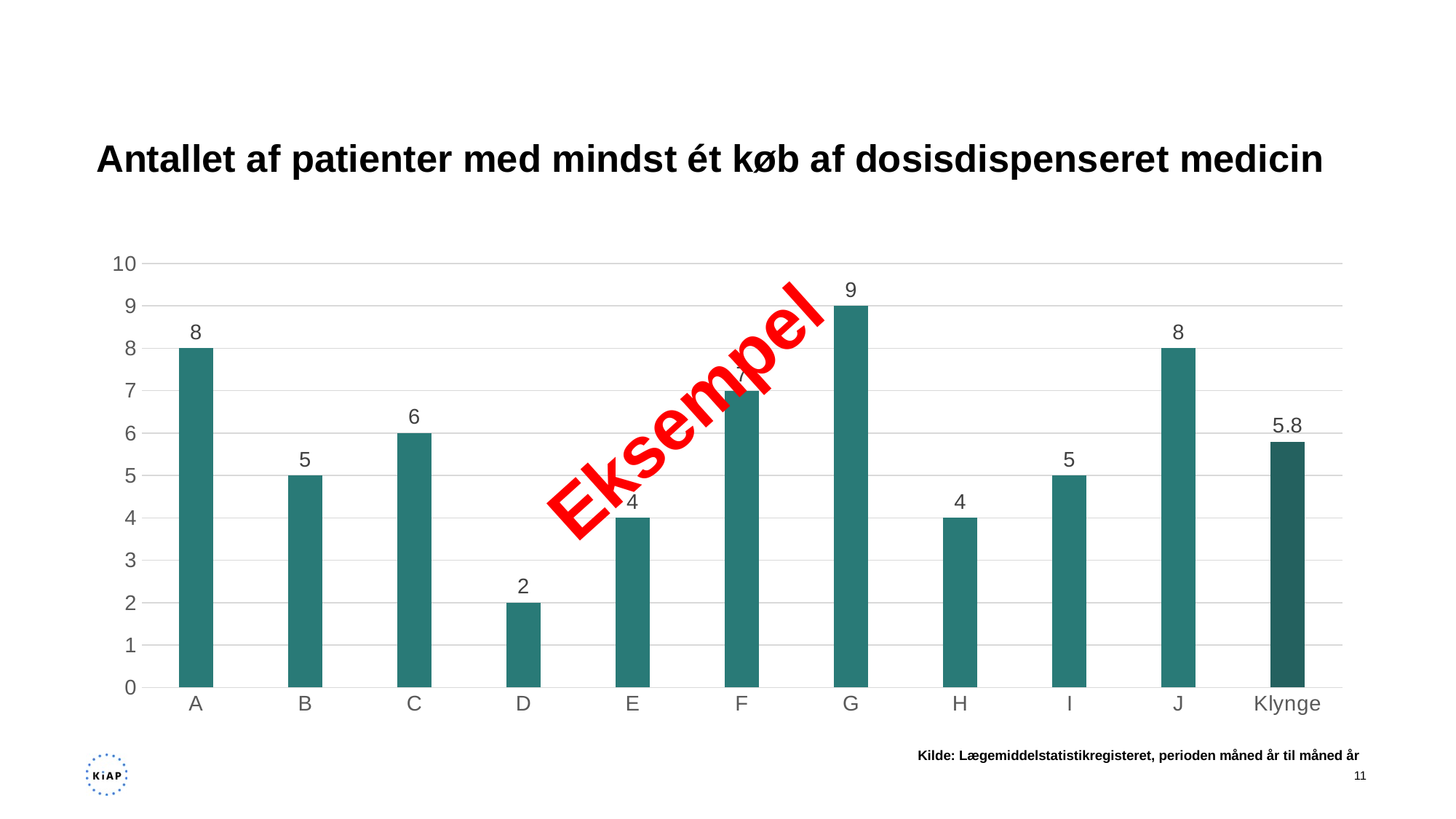
Which category has the highest value? G What is the value for category D? 2 How many categories are shown on the x axis? 11 What is the value for category G? 9 What is the difference between the values for G and D? 7 What is the value for Klynge? 5.8 What is the difference between the values for A and B? 3 What kind of chart is shown on the slide? bar chart What is the title of the chart? Antallet af patienter med mindst ét køb af dosisdispenseret medicin Which is larger, the value for C or the value for H? C Which category has the lowest value? D Is the value for F greater or less than 5? greater